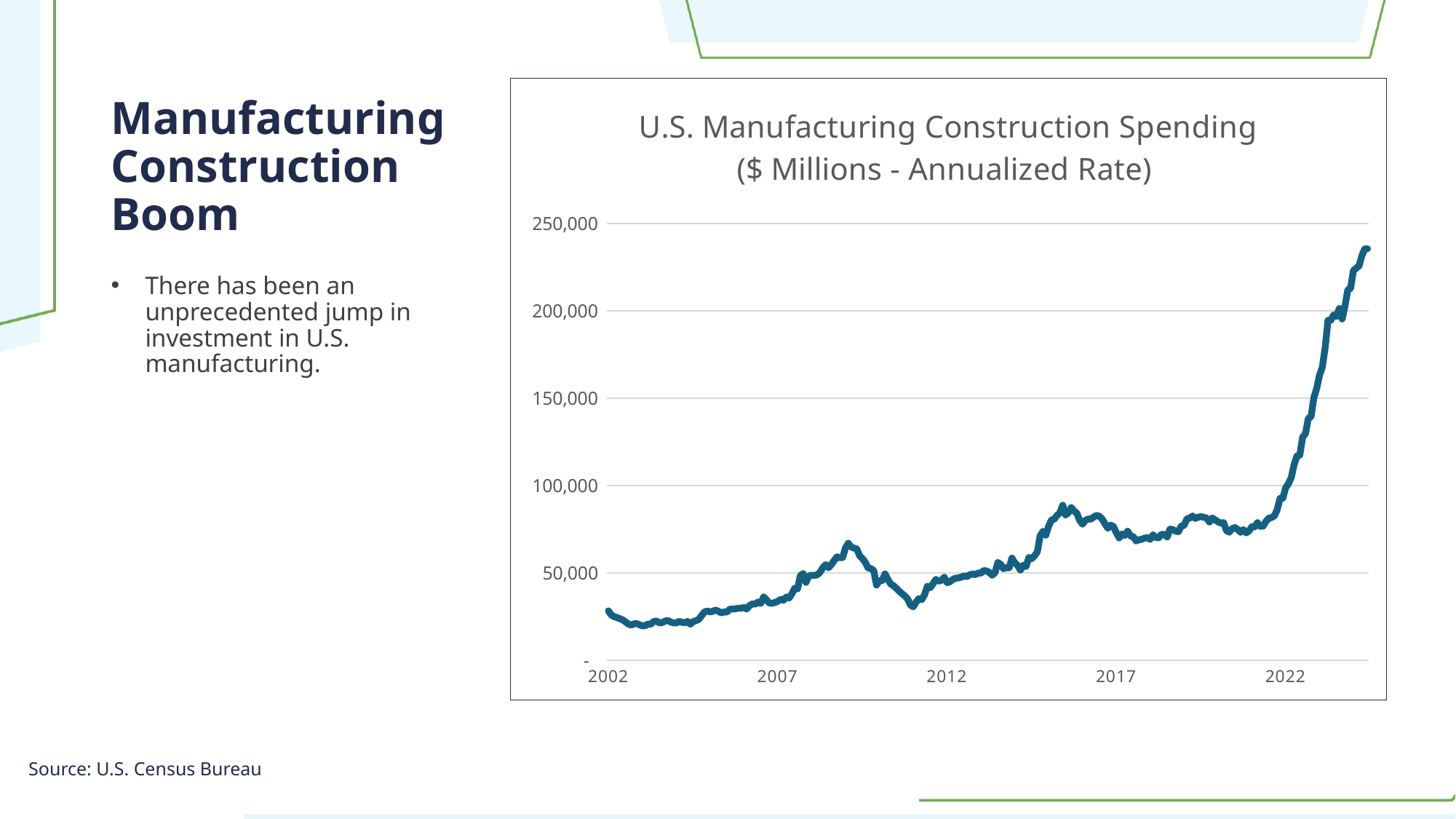
Is the most recent value at the right end of the line greater or less than 200,000? greater Does the line rise or fall after 2022? Rise What is the first year label shown on the x axis? 2002 What is the title of the chart? U.S. Manufacturing Construction Spending ($ Millions - Annualized Rate) What kind of chart is shown on the slide? Line chart Is the value for 2017 greater or less than 100,000? less How many data series are plotted on the chart? 1 Does the line overall rise or fall from 2002 to the end of the series? Rise Which of the two values is larger: the value for 2022 or the value for 2002? 2022 Is the value for 2007 greater or less than 50,000? less